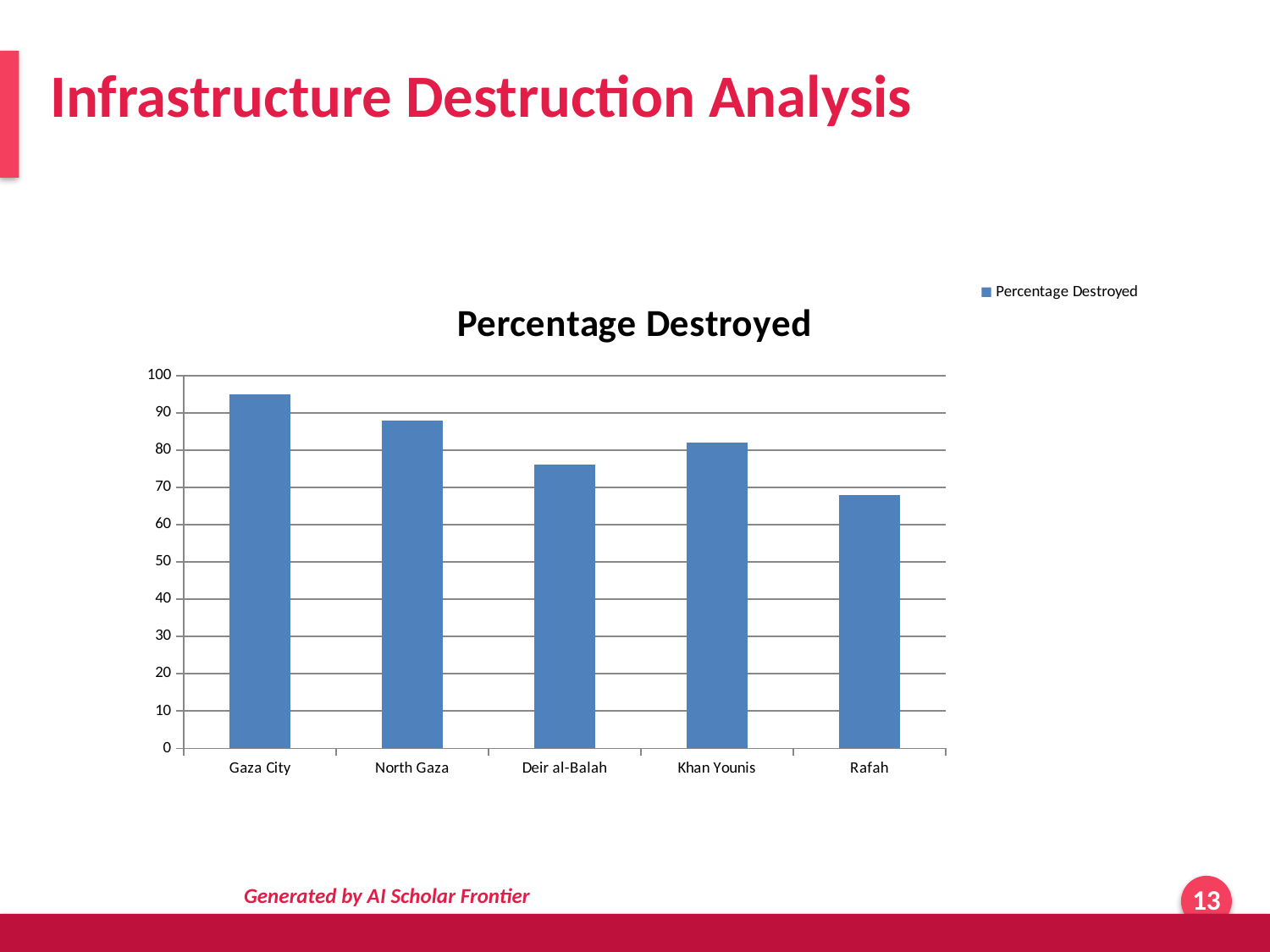
Is the value for Gaza City greater or less than 90? greater Is the value for Rafah greater or less than 70? less What type of chart is shown on the slide? bar chart Which has a higher Percentage Destroyed, North Gaza or Khan Younis? North Gaza Which has a higher Percentage Destroyed, Deir al-Balah or Khan Younis? Khan Younis Which category has the highest Percentage Destroyed? Gaza City What is the title of the chart? Percentage Destroyed How many series does the legend list? 1 How many categories are shown on the x axis of the chart? 5 Is the value for Deir al-Balah greater or less than 70? greater Which category has the lowest Percentage Destroyed? Rafah